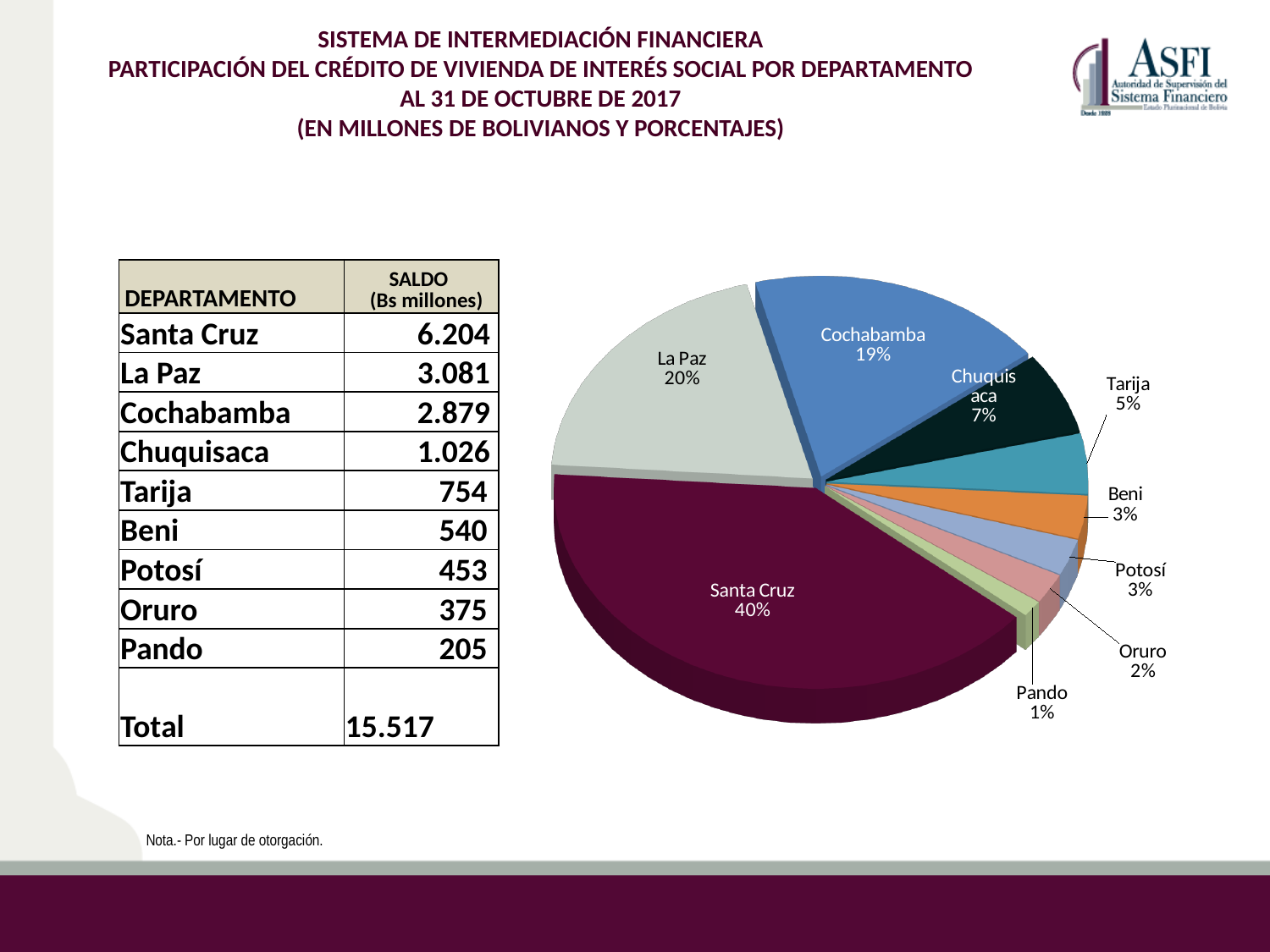
What is the difference in percentage points between the Santa Cruz slice and the La Paz slice in the pie chart? 20% What share of the pie chart does Tarija represent? 5% How many departments (slices) are shown in the pie chart? 9 Which department has the largest slice in the pie chart? Santa Cruz What share of the pie chart does Pando represent? 1% Which department has the smallest slice in the pie chart? Pando What share of the pie chart does Cochabamba represent? 19% In the pie chart, which slice is larger, La Paz or Cochabamba? La Paz What kind of chart is shown on the slide? Pie chart